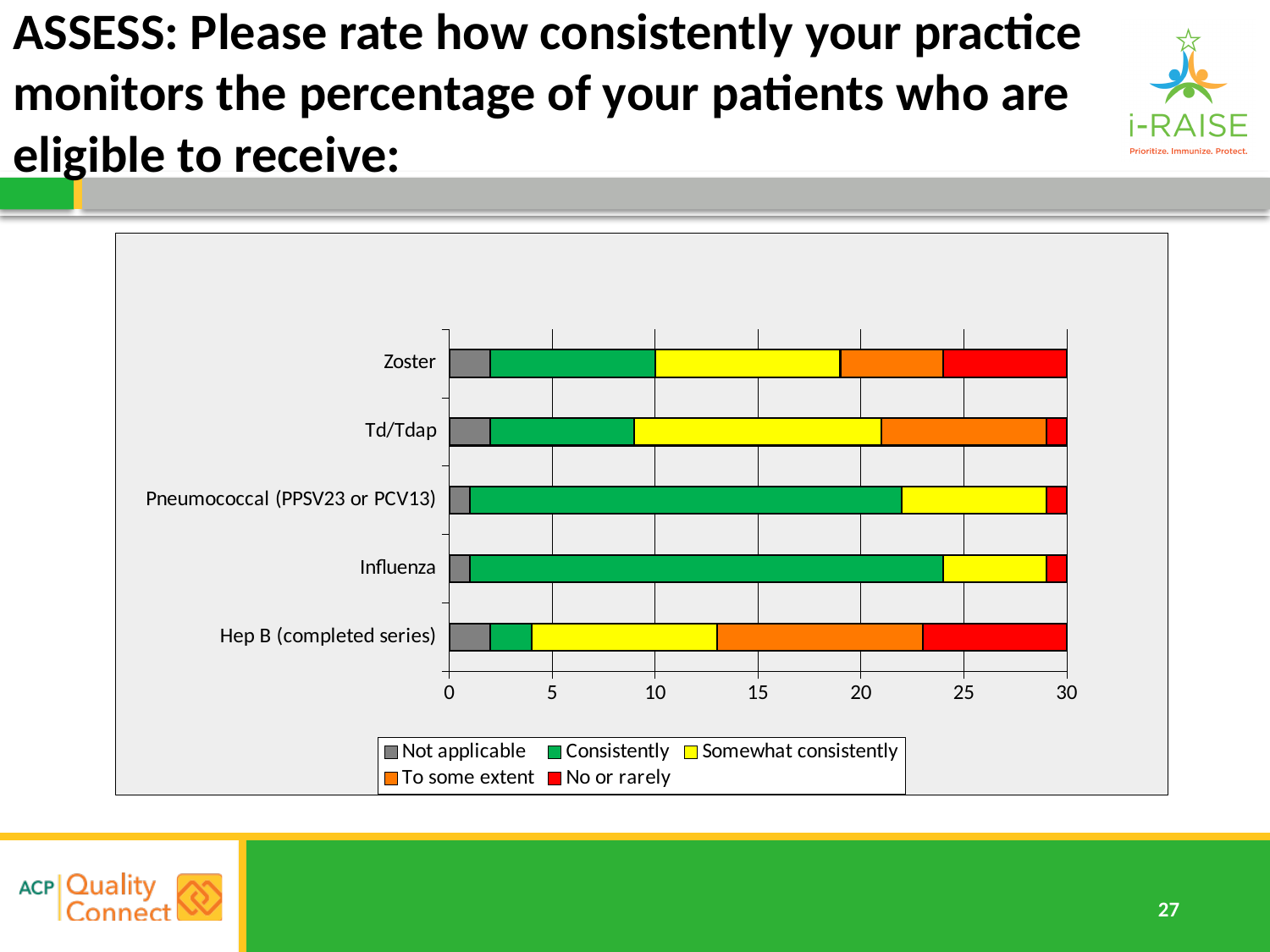
Is the "Consistently" value for Hep B (completed series) greater or less than 5? less What is the total length of the stacked bar for Zoster? 30 Which is larger, the "Consistently" segment for Influenza or for Hep B (completed series)? Influenza How many vaccine categories are plotted on the chart? 5 Is the "Consistently" value for Zoster greater or less than 5? greater What colour represents the "No or rarely" series in the legend? red Is the "Consistently" value for Influenza greater or less than 20? greater How many series does the legend list? 5 What is the first entry listed in the legend? Not applicable Which category has the smallest "Consistently" segment? Hep B (completed series) What kind of chart is shown on the slide? bar chart Which category has the largest "Consistently" segment? Influenza